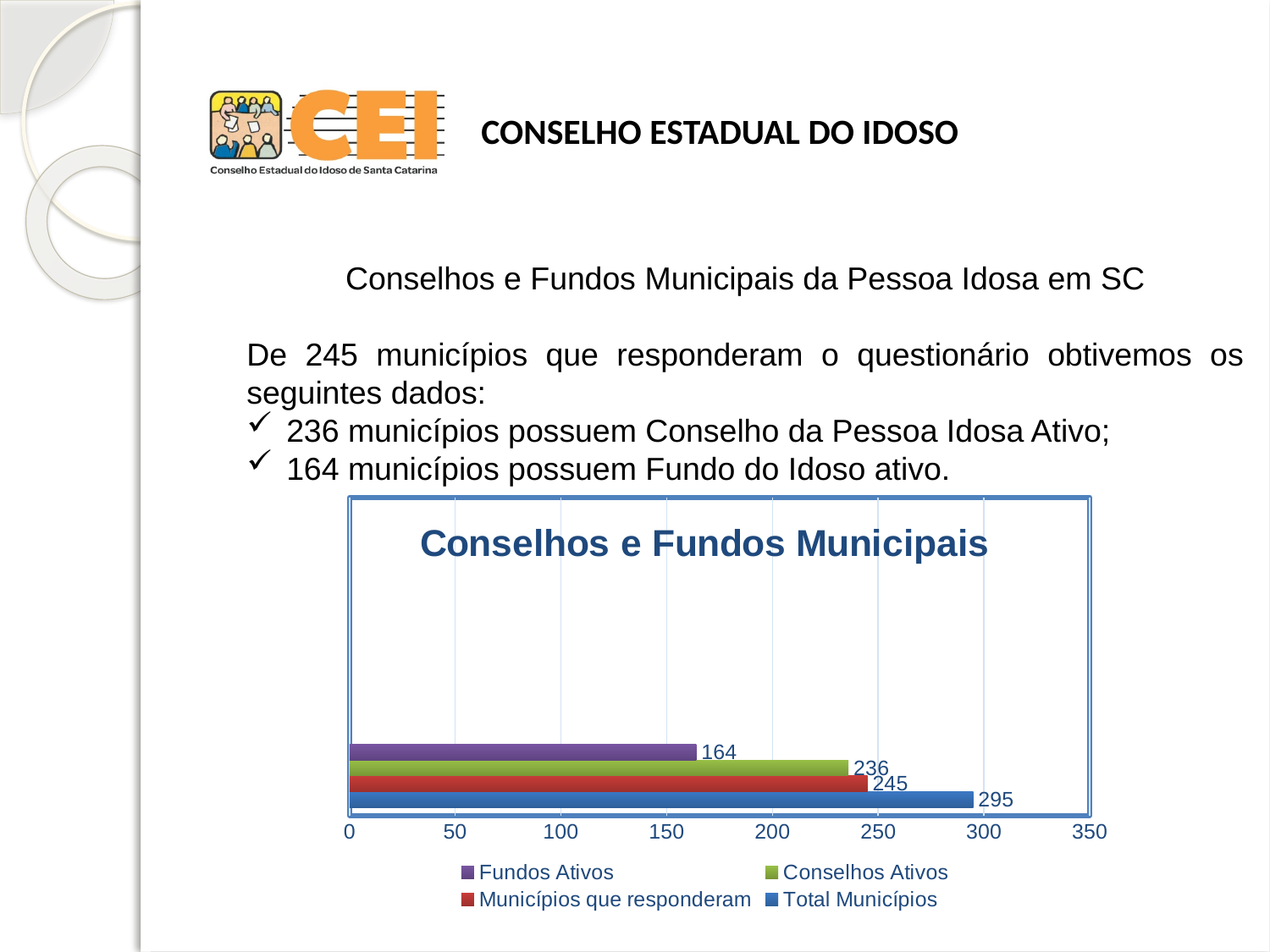
Which series has the highest value in the chart? Total Municípios What is the value for Fundos Ativos in the chart? 164 What is the difference between Conselhos Ativos and Fundos Ativos? 72 What is the value for Total Municípios in the chart? 295 What is the title of the chart? Conselhos e Fundos Municipais What is the value for Conselhos Ativos in the chart? 236 Which is larger, Conselhos Ativos or Fundos Ativos? Conselhos Ativos Which series has the lowest value in the chart? Fundos Ativos What is the difference between Total Municípios and Municípios que responderam? 50 How many series does the legend list? 4 What kind of chart is shown on the slide? Bar chart What is the value for Municípios que responderam in the chart? 245